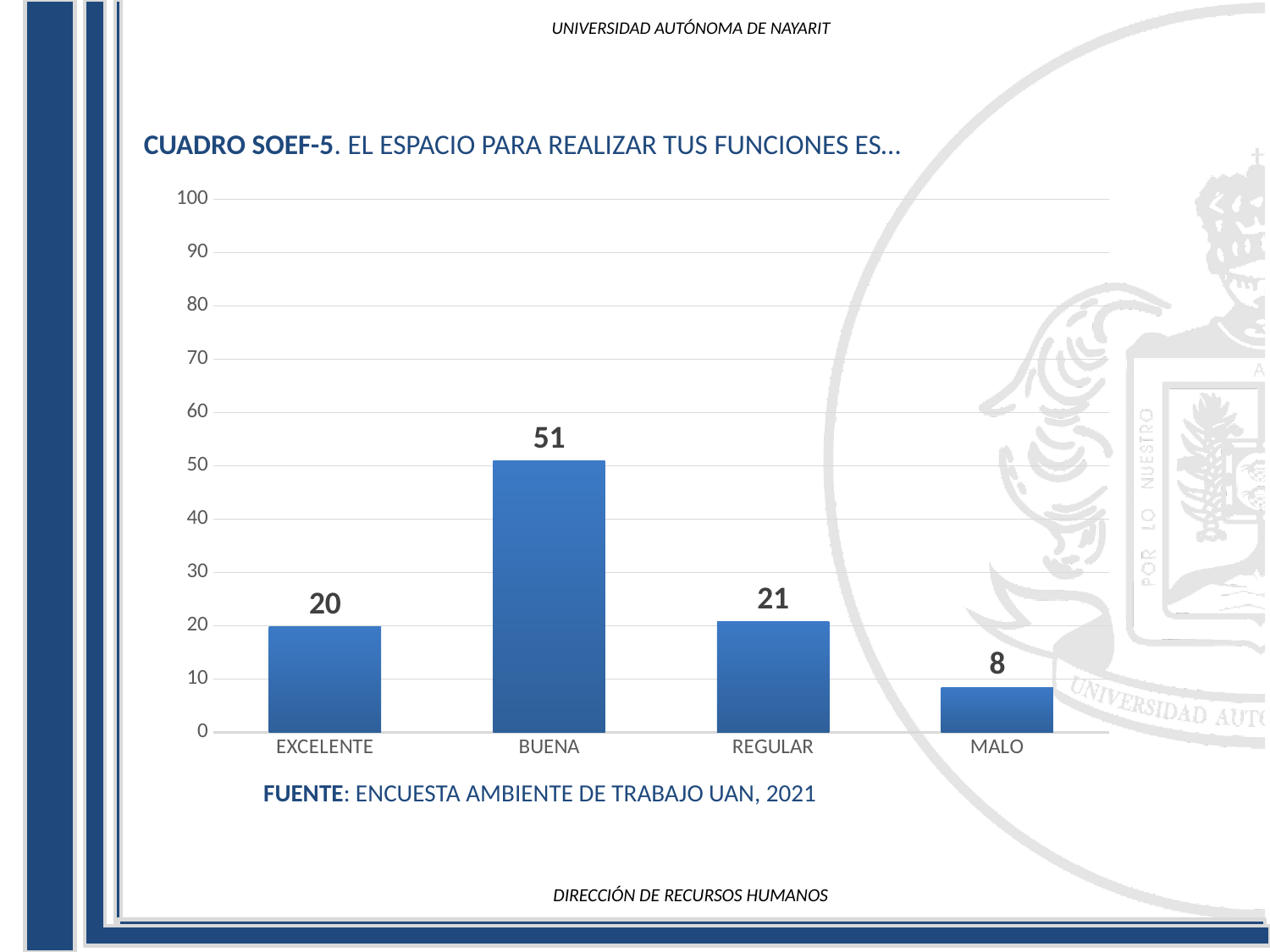
What is the value for EXCELENTE? 20 Which category has the lowest value? MALO Is the value for REGULAR greater or less than 30? less What is the value for MALO? 8 What is the difference between the values for EXCELENTE and MALO? 12 What is the difference between the values for BUENA and REGULAR? 30 What source is cited below the chart? ENCUESTA AMBIENTE DE TRABAJO UAN, 2021 Which category has the highest value? BUENA What is the value for BUENA? 51 Which is larger, the value for BUENA or the value for EXCELENTE? BUENA What kind of chart is shown on the slide? bar chart How many categories are shown on the x axis? 4